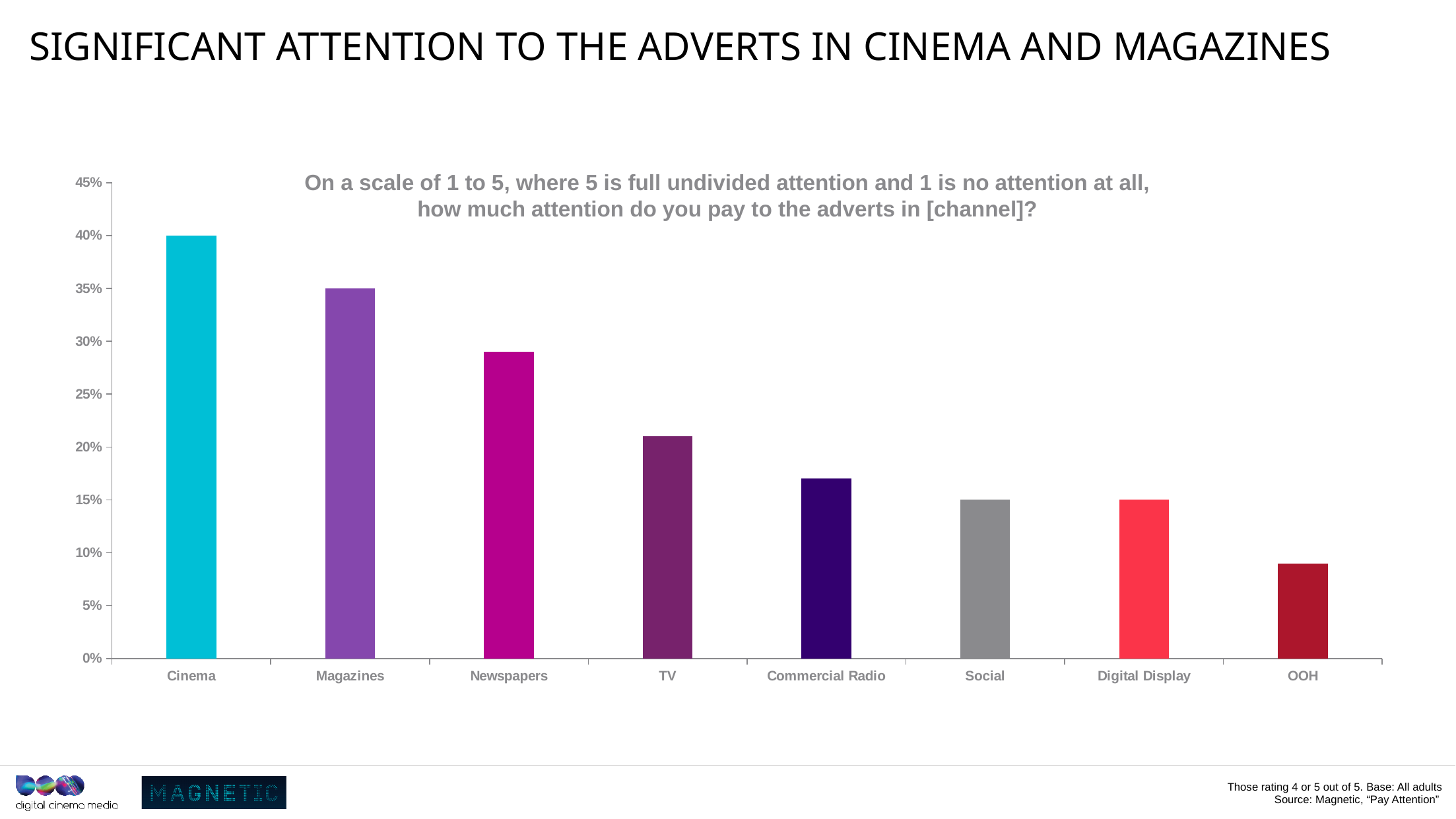
Which channel has the highest share of people paying attention to its adverts? Cinema What is the value for Magazines? 35% What is the value for Cinema? 40% Which is larger, the value for TV or the value for Commercial Radio? TV Is the value for OOH greater or less than 10%? less What is the difference between the values for Cinema and Magazines? 5% How many channels are shown on the x axis of the chart? 8 Is the value for Newspapers greater or less than 25%? greater Do the values rise or fall moving from left to right along the x axis? fall What is the value for Social? 15% Which channel has the lowest share of people paying attention to its adverts? OOH What kind of chart is shown on the slide? bar chart